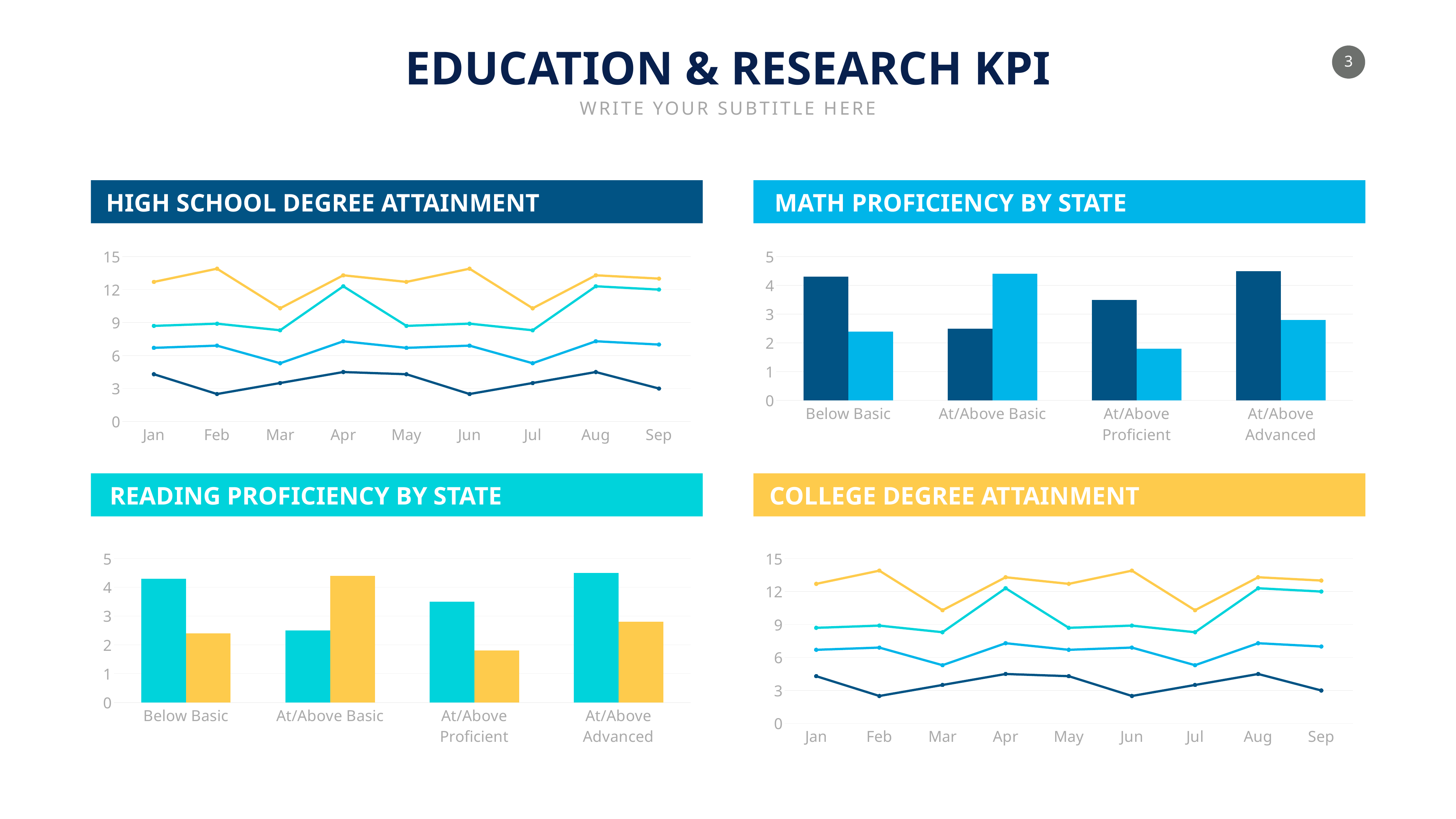
In the Reading Proficiency by State chart, for Below Basic, is the teal bar or the yellow bar taller? teal bar In the Reading Proficiency by State chart, which category has the shortest teal bar? At/Above Basic In the High School Degree Attainment chart, is the yellow line's value for Feb greater or less than 12? greater What kind of chart is the Math Proficiency by State chart? bar chart What kind of chart is the High School Degree Attainment chart? line chart How many categories are shown on the x axis of the Reading Proficiency by State chart? 4 In the Math Proficiency by State chart, which category has the tallest light blue bar? At/Above Basic In the College Degree Attainment chart, does the yellow line rise or fall from Jan to Feb? rise How many months are shown on the x axis of the College Degree Attainment chart? 9 In the Math Proficiency by State chart, is the dark blue bar for Below Basic greater or less than 4? greater In the Math Proficiency by State chart, which category has the shortest light blue bar? At/Above Proficient How many lines are plotted on the High School Degree Attainment chart? 4